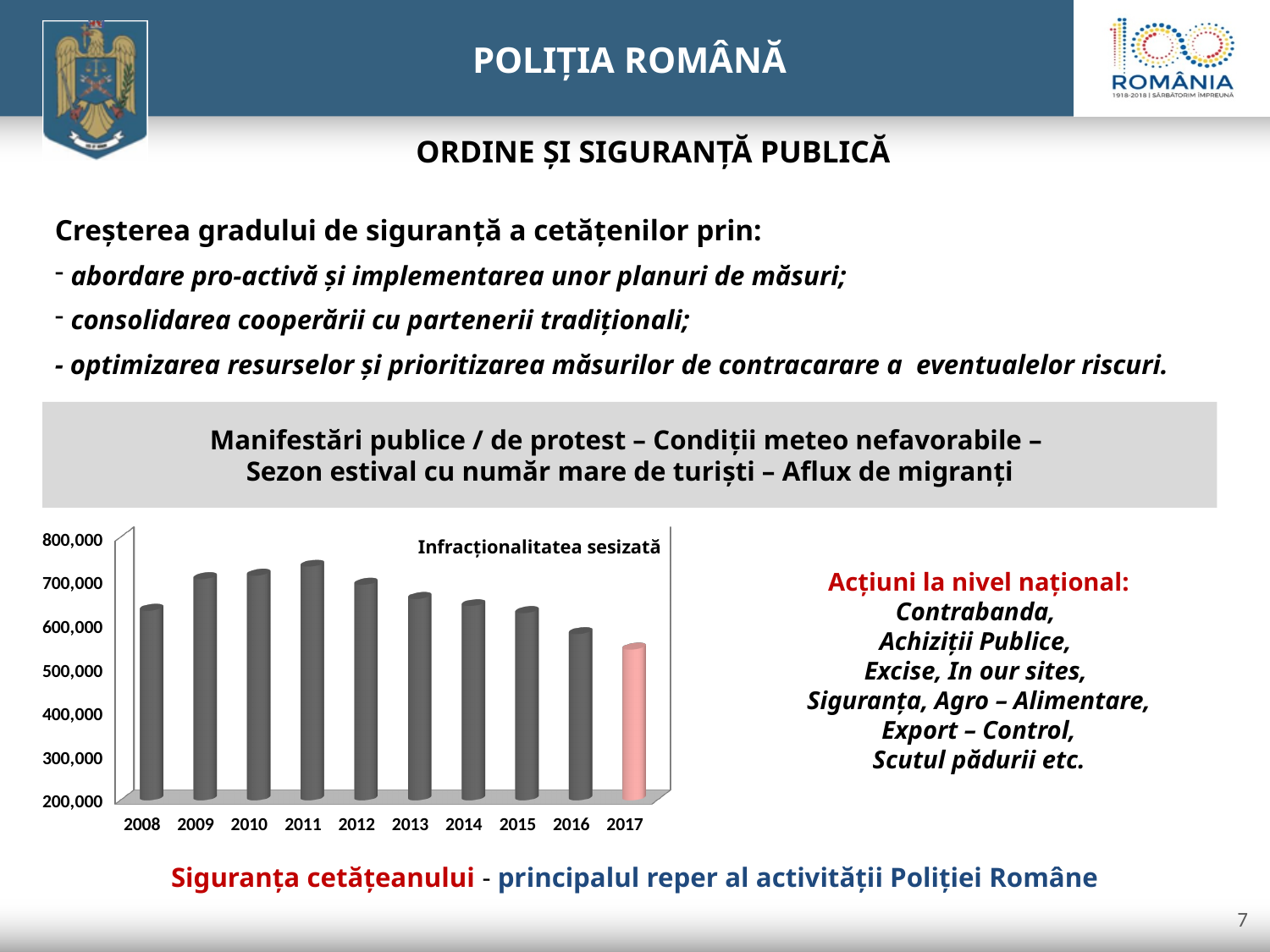
How many years are shown on the x axis of the chart? 10 Which is larger, the value for 2008 or the value for 2016? 2008 What is the title of the chart? Infracționalitatea sesizată Is the value for 2008 greater or less than 600,000? greater What kind of chart is shown on the slide? bar chart Which year's bar is shown in a different colour (pink) from the others? 2017 Is the value for 2016 greater or less than 600,000? less Is the value for 2017 greater or less than 600,000? less Do the values rise or fall from 2011 to 2017? fall Which year has the lowest value in the chart? 2017 Which year has the highest value in the chart? 2011